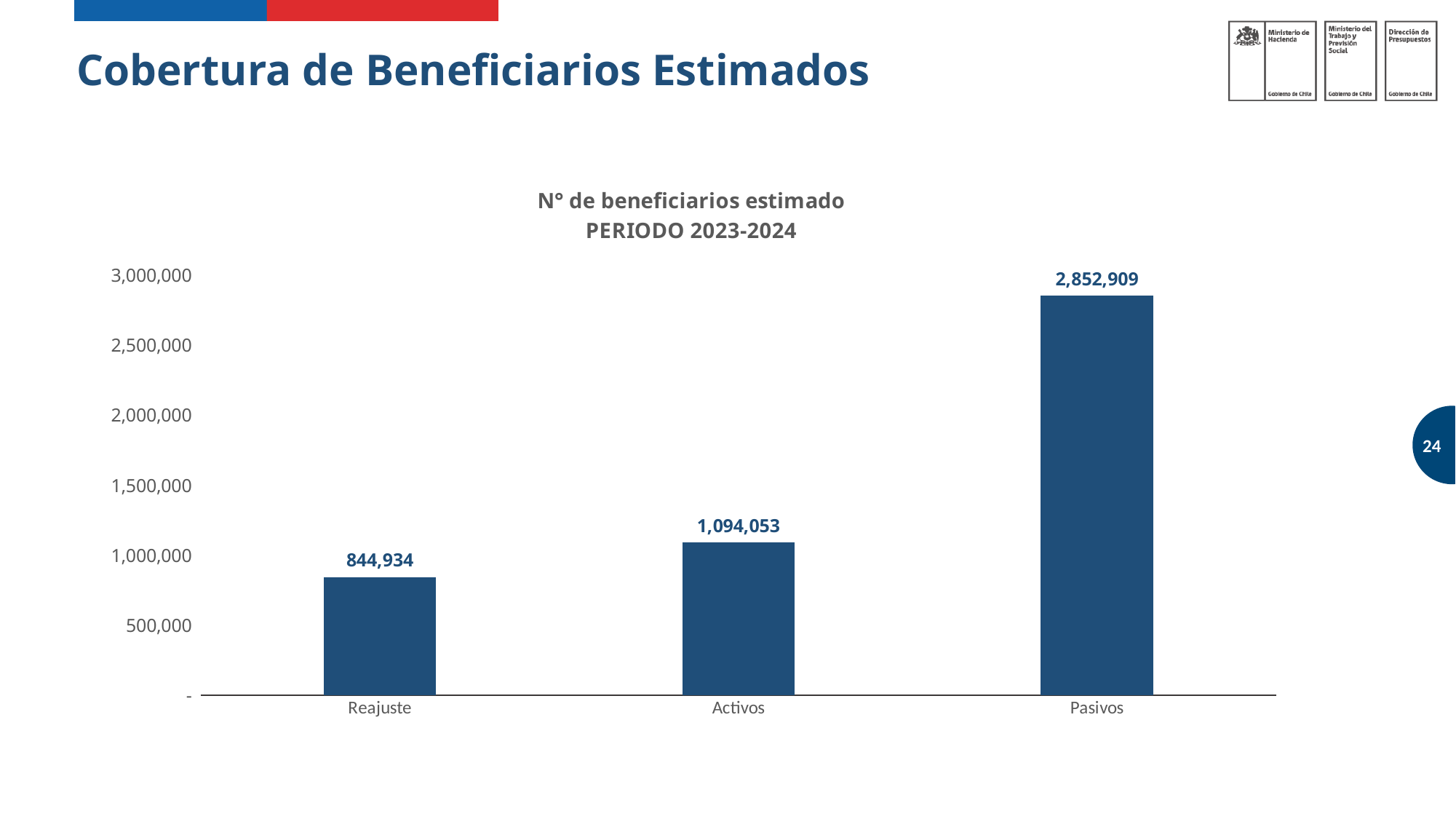
What is the value for Pasivos? 2,852,909 Is the value for Pasivos greater or less than 2,500,000? greater What is the difference between the values for Pasivos and Activos? 1,758,856 What is the difference between the values for Activos and Reajuste? 249,119 Which category has the lowest value? Reajuste How many categories are shown on the x axis? 3 What is the value for Reajuste? 844,934 What kind of chart is shown on the slide? bar chart What is the title of the chart? N° de beneficiarios estimado PERIODO 2023-2024 Which is larger, the value for Activos or the value for Reajuste? Activos Which category has the highest value? Pasivos What is the value for Activos? 1,094,053